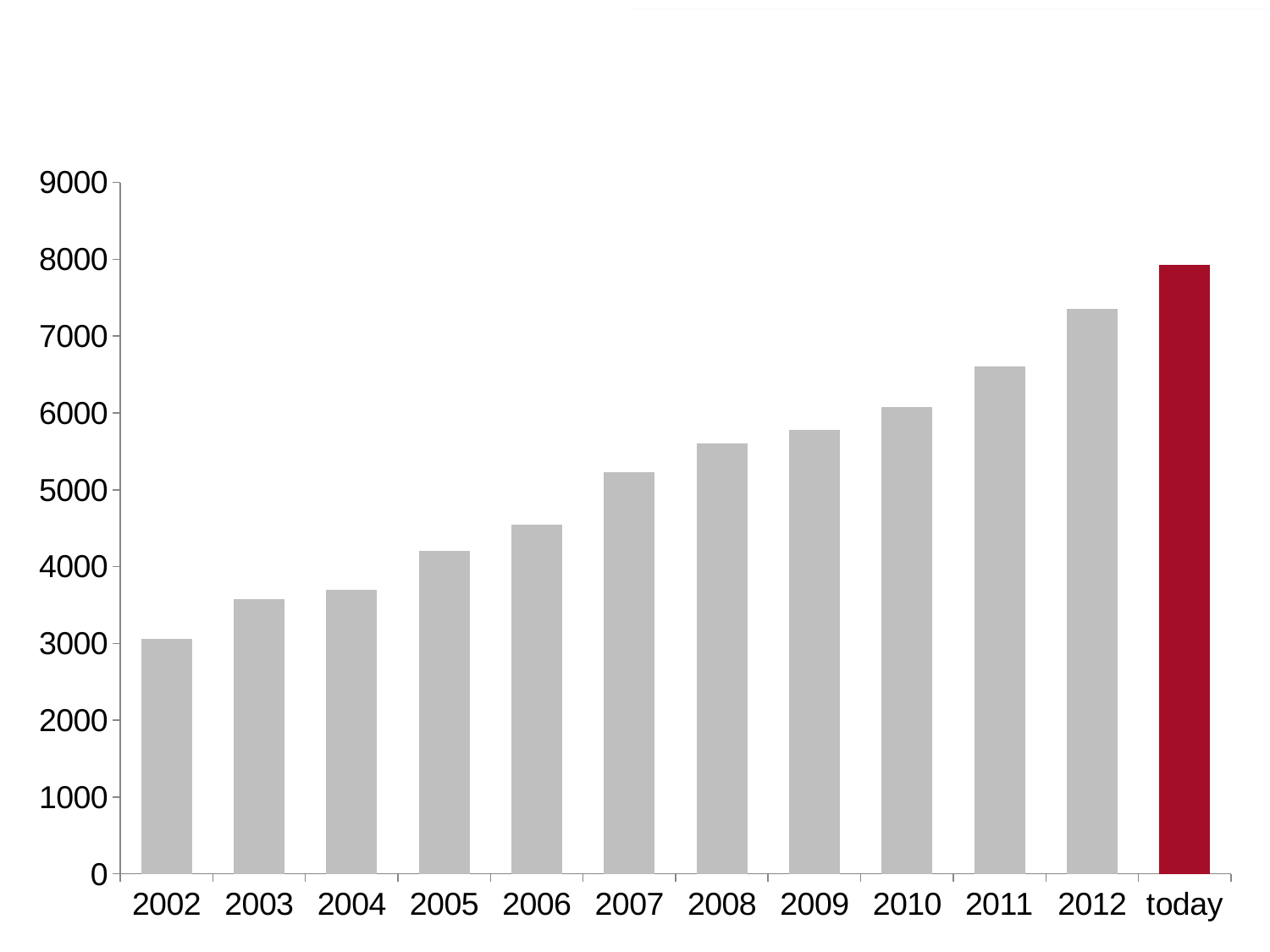
How many bars are plotted on the chart? 12 Is the value for 2012 greater or less than 7000? greater Do the values rise or fall from 2002 to today? rise Is the value for 2007 greater or less than 5000? greater Is the value for 2005 greater or less than 4000? greater What kind of chart is shown on the slide? bar chart Which category has the highest bar? today Which is larger, the value for 2010 or the value for 2008? 2010 What colour is the bar for today? dark red Which year has the lowest bar? 2002